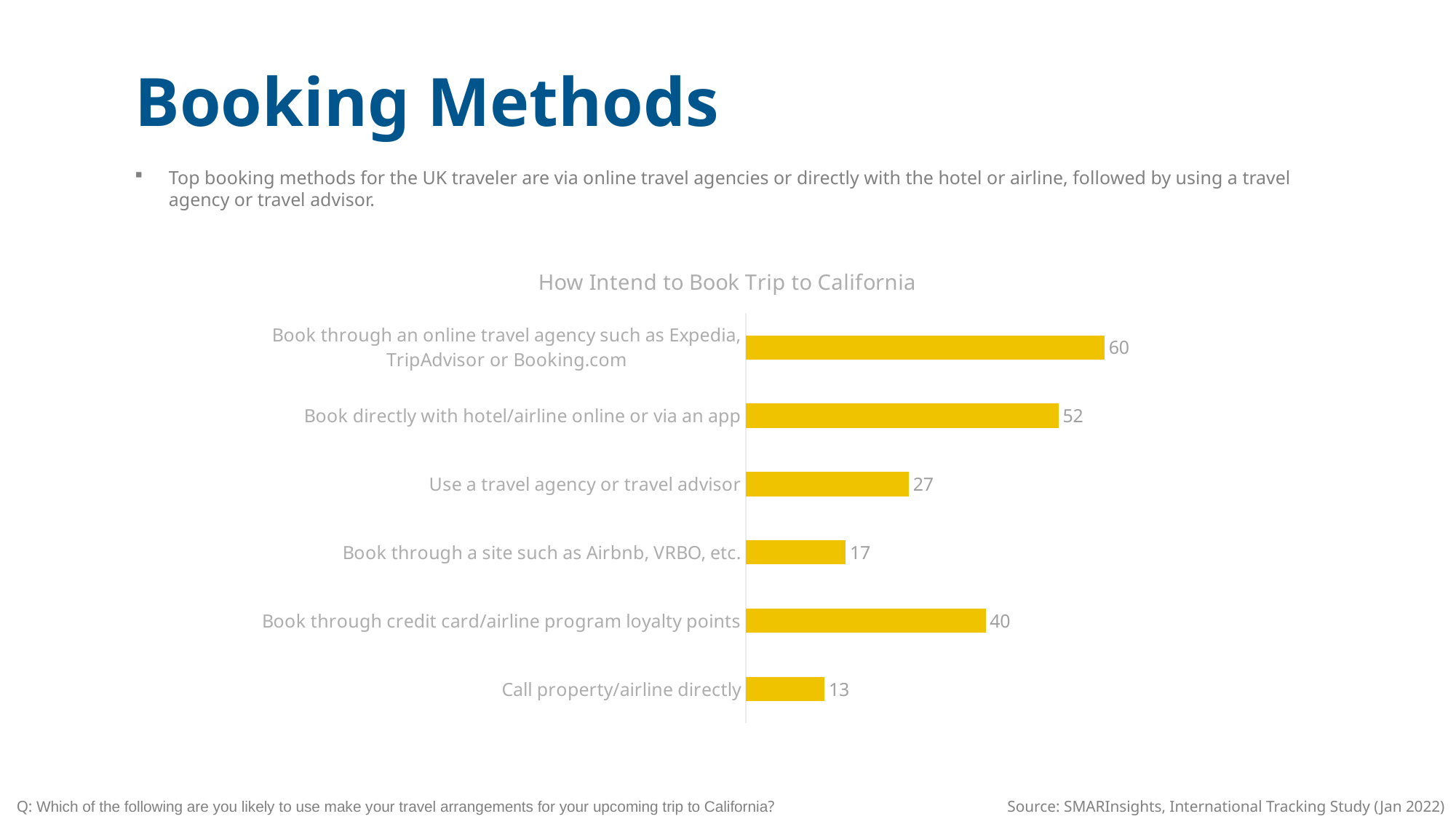
What is the value for 'Book through an online travel agency such as Expedia, TripAdvisor or Booking.com'? 60 Which booking method has the highest value? Book through an online travel agency such as Expedia, TripAdvisor or Booking.com What kind of chart is shown on the slide? Bar chart What is the difference between the values for 'Book through credit card/airline program loyalty points' and 'Book through a site such as Airbnb, VRBO, etc.'? 23 Which booking method has the lowest value? Call property/airline directly What is the title of the chart? How Intend to Book Trip to California What is the value for 'Book through credit card/airline program loyalty points'? 40 What is the value for 'Use a travel agency or travel advisor'? 27 How many booking methods are shown in the chart? 6 What is the value for 'Book directly with hotel/airline online or via an app'? 52 Which is larger: the value for 'Use a travel agency or travel advisor' or the value for 'Book through credit card/airline program loyalty points'? Book through credit card/airline program loyalty points What is the difference between the values for 'Book through an online travel agency such as Expedia, TripAdvisor or Booking.com' and 'Book directly with hotel/airline online or via an app'? 8